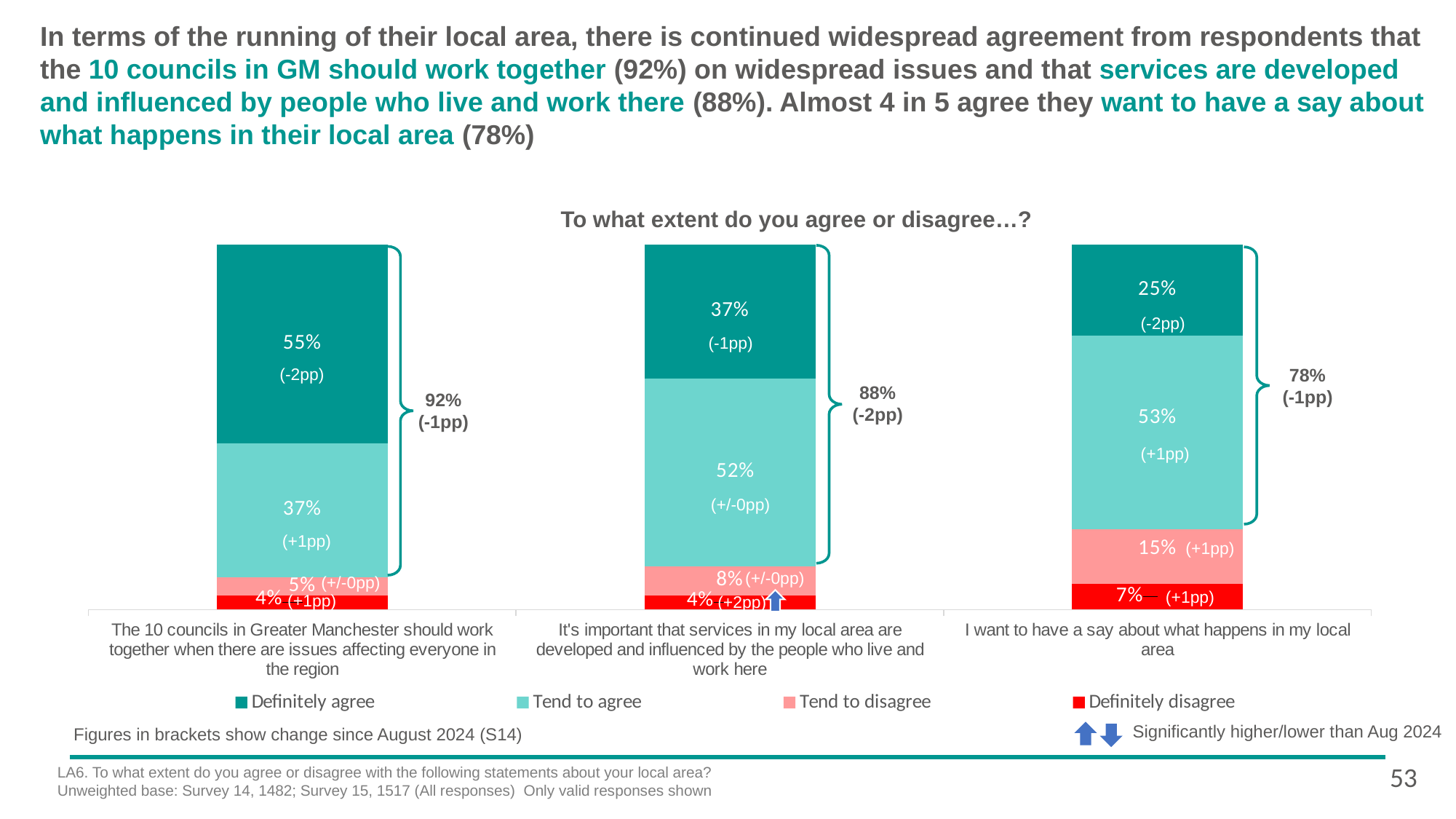
Is the 'Tend to agree' percentage higher for the services statement or for the 'I want to have a say' statement? I want to have a say about what happens in my local area How many statements are shown in the chart? 3 How many series does the legend list? 4 What is the difference between the 'Definitely agree' percentage for the 10 councils working together statement and the 'Definitely agree' percentage for the 'I want to have a say' statement? 30 percentage points What percentage of respondents 'Definitely agree' that the 10 councils in Greater Manchester should work together when there are issues affecting everyone in the region? 55% Which statement has the highest 'Definitely agree' percentage? The 10 councils in Greater Manchester should work together when there are issues affecting everyone in the region What is the change since August 2024 shown for the 'Definitely disagree' share of the services statement? +2pp What percentage of respondents 'Tend to agree' that it's important that services in their local area are developed and influenced by the people who live and work there? 52% What kind of chart is shown on the slide? Stacked bar chart What is the combined agreement (Definitely agree plus Tend to agree) shown for the statement 'I want to have a say about what happens in my local area'? 78% What percentage of respondents 'Tend to disagree' with the statement 'I want to have a say about what happens in my local area'? 15% Which statement has the lowest 'Definitely agree' percentage? I want to have a say about what happens in my local area